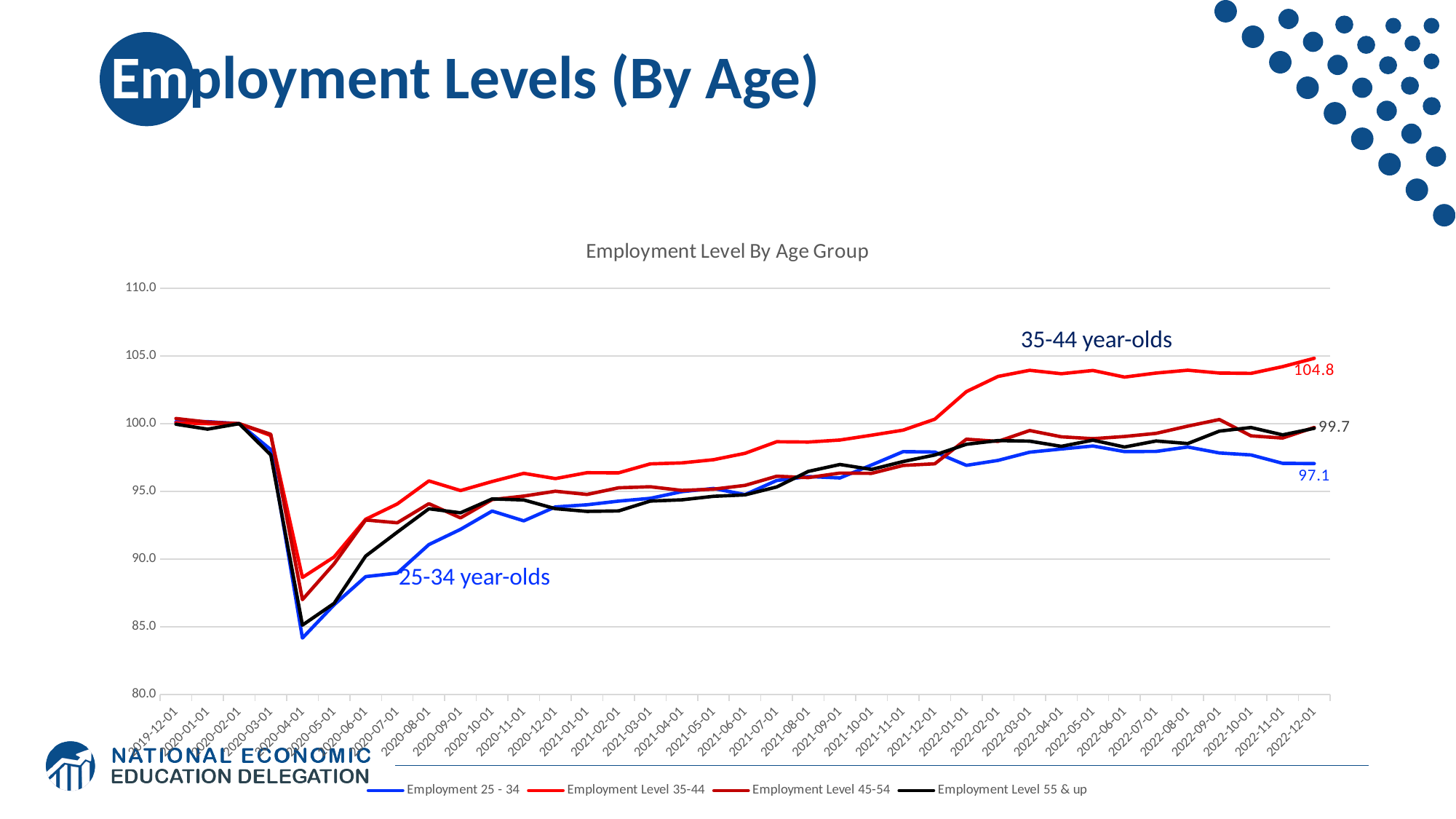
What kind of chart is shown on the slide? Line chart What is the value of Employment 25 - 34 at 2022-12-01? 97.1 Which series has the lowest value at 2022-12-01? Employment 25 - 34 What is the difference between Employment Level 35-44 and Employment 25 - 34 at 2022-12-01? 7.7 Is the value for Employment 25 - 34 at 2020-04-01 greater or less than 85.0? less Which series has the highest value at 2022-12-01? Employment Level 35-44 What is the value of Employment Level 55 & up at 2022-12-01? 99.7 How many series does the legend list? 4 What is the value of Employment Level 35-44 at 2022-12-01? 104.8 At 2022-12-01, which is larger: Employment Level 35-44 or Employment Level 55 & up? Employment Level 35-44 What is the difference between Employment Level 55 & up and Employment 25 - 34 at 2022-12-01? 2.6 What is the title of the chart? Employment Level By Age Group